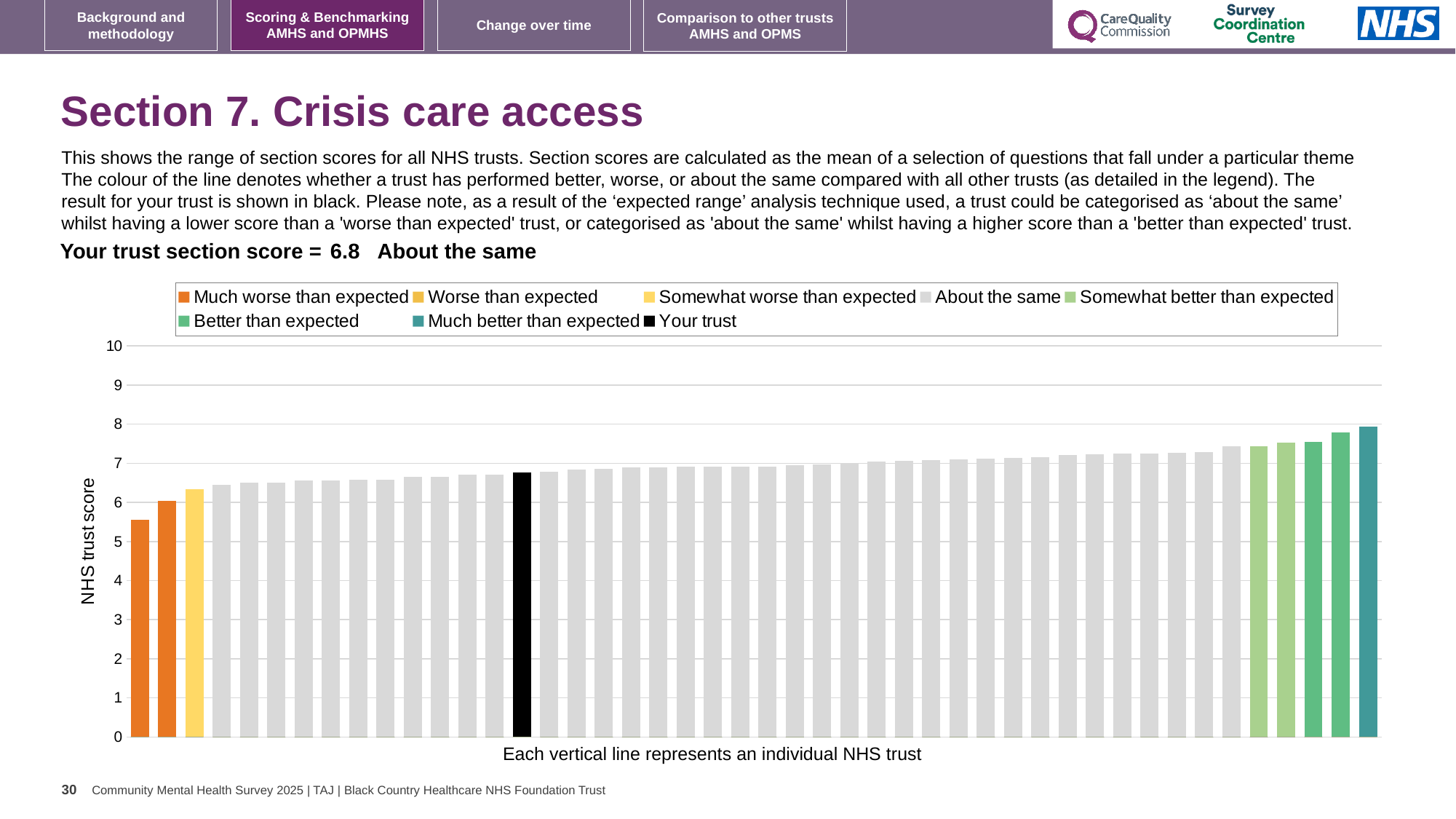
Which category is your trust placed in for this section? About the same Which legend category does the highest bar on the chart belong to? Much better than expected Which legend category does the lowest bar on the chart belong to? Much worse than expected Is the value of the leftmost (lowest) bar greater or less than 6? less What kind of chart is shown on the slide? Bar chart Is the value of the black bar (your trust) greater or less than 5? greater Which is higher, the black bar for your trust or the leftmost orange bar? The black bar How many entries does the chart legend list? 8 Is the value of the rightmost (highest) bar greater or less than 7? greater What is the label on the vertical axis of the chart? NHS trust score What is the section score for your trust shown on the slide? 6.8 Do the bar values rise or fall from left to right along the x axis? Rise